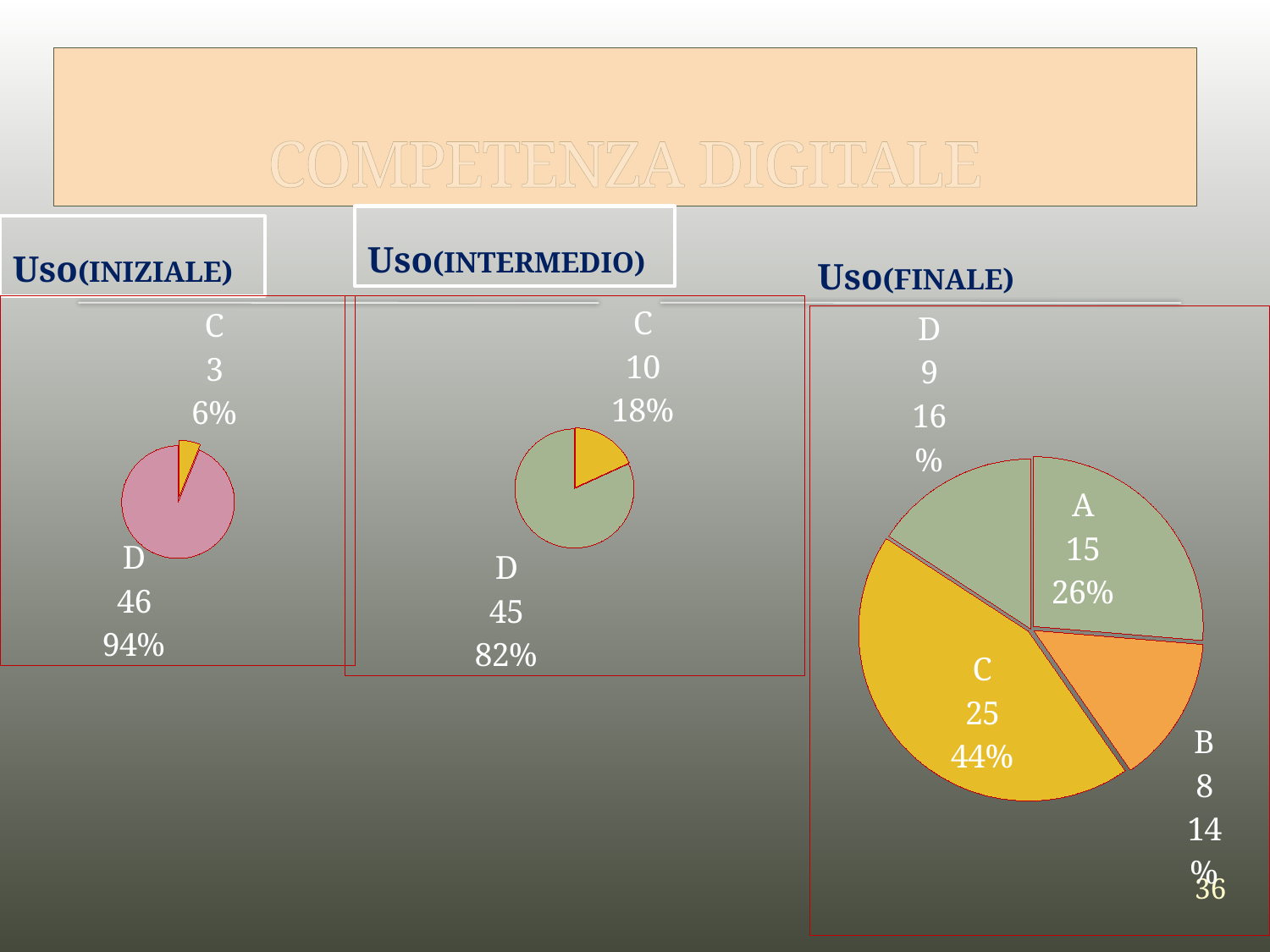
In the Uso (Finale) chart, which category has the largest slice? C In the Uso (Intermedio) chart, what value is shown for category C? 10 In the Uso (Finale) chart, what is the difference between the values for C and D? 16 What kind of chart is the Uso (Intermedio) chart? Pie chart In the Uso (Finale) chart, which category has the smallest slice? B In the Uso (Finale) chart, what value is shown for category A? 15 In the Uso (Iniziale) chart, what value is shown for category D? 46 In the Uso (Iniziale) chart, what percentage share does category C have? 6% How many categories are shown in the Uso (Finale) chart? 4 In the Uso (Intermedio) chart, what percentage share does category D have? 82% How many pie charts are shown on the slide? 3 In the Uso (Finale) chart, which is larger, the value for A or the value for B? A